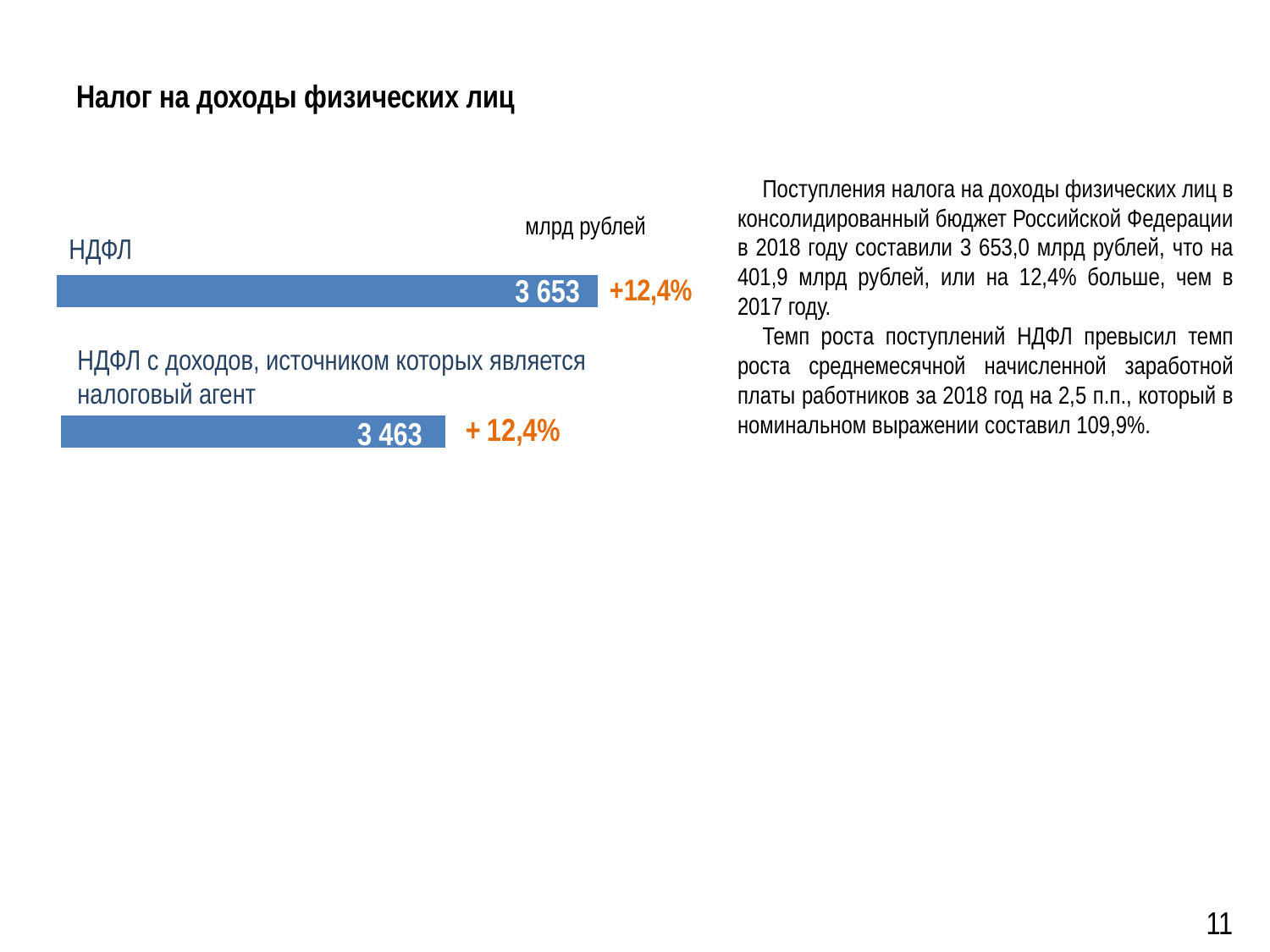
What is the value shown for НДФЛ? 3 653 Which bar is longer: НДФЛ or НДФЛ с доходов, источником которых является налоговый агент? НДФЛ How many bars are shown on the chart? 2 What is the value shown for НДФЛ с доходов, источником которых является налоговый агент? 3 463 What is the difference between the НДФЛ value and the value for НДФЛ с доходов, источником которых является налоговый агент? 190 What colour are the bars on the chart? Blue In what units are the chart values given? млрд рублей Which category has the highest value on the chart? НДФЛ Which category has the lowest value on the chart? НДФЛ с доходов, источником которых является налоговый агент What growth percentage is shown next to the НДФЛ bar? +12,4% What growth percentage is shown next to the bar for НДФЛ с доходов, источником которых является налоговый агент? + 12,4% What type of chart is shown on the slide? Bar chart